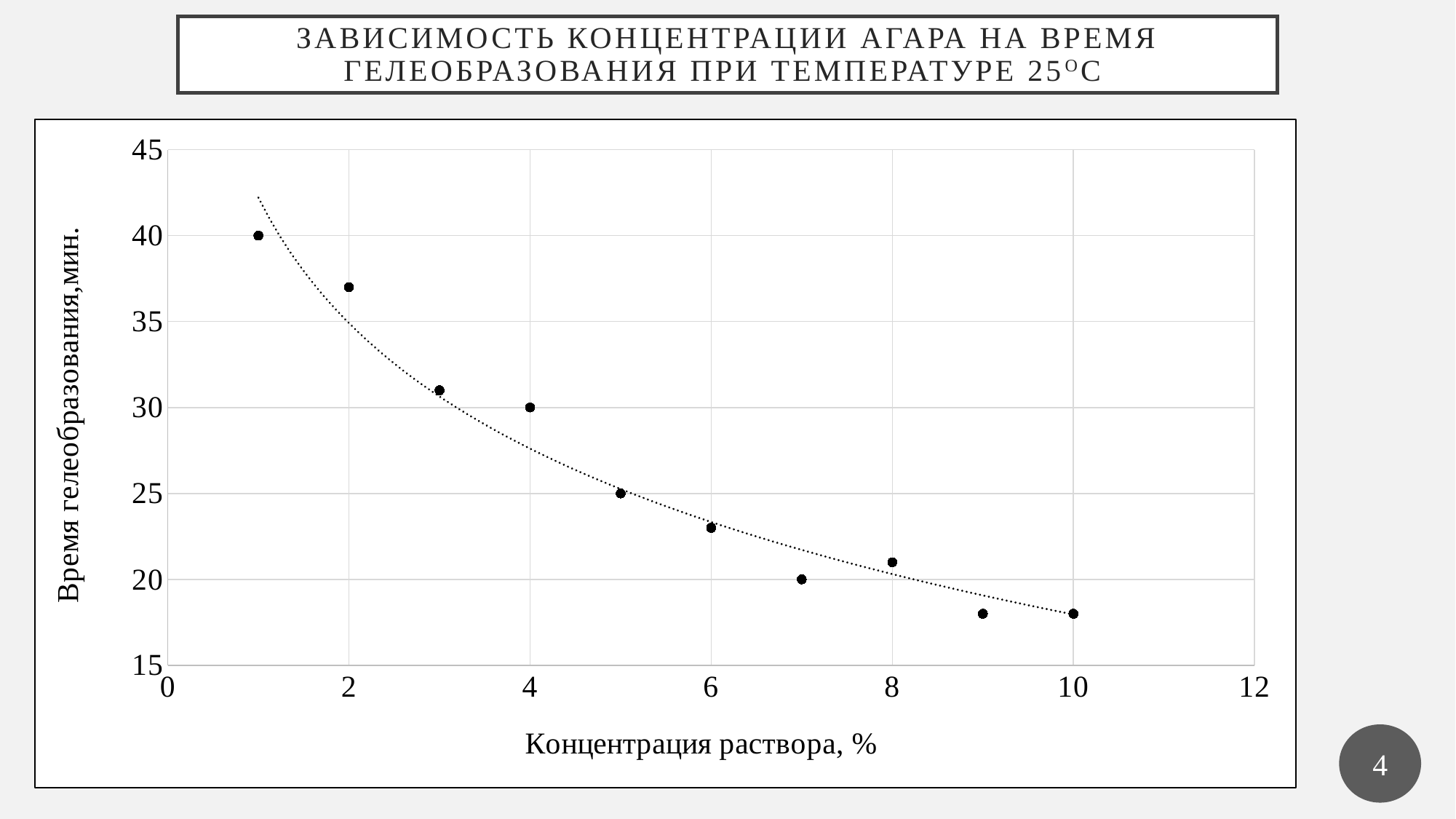
Is the gelation time at a concentration of 9% greater or less than 20? less What kind of chart is shown on the slide? scatter chart Does the gelation time rise or fall as the solution concentration increases? fall Is the gelation time at a concentration of 2% greater or less than 35? greater What is the gelation time at a solution concentration of 5%? 25 What is the gelation time at a solution concentration of 1%? 40 What is the gelation time at a solution concentration of 4%? 30 What is the gelation time at a solution concentration of 7%? 20 How many data points are plotted on the chart? 10 Which has a longer gelation time: a concentration of 2% or 6%? 2% What is the difference in gelation time between concentrations of 1% and 4%? 10 At which solution concentration is the gelation time highest? 1